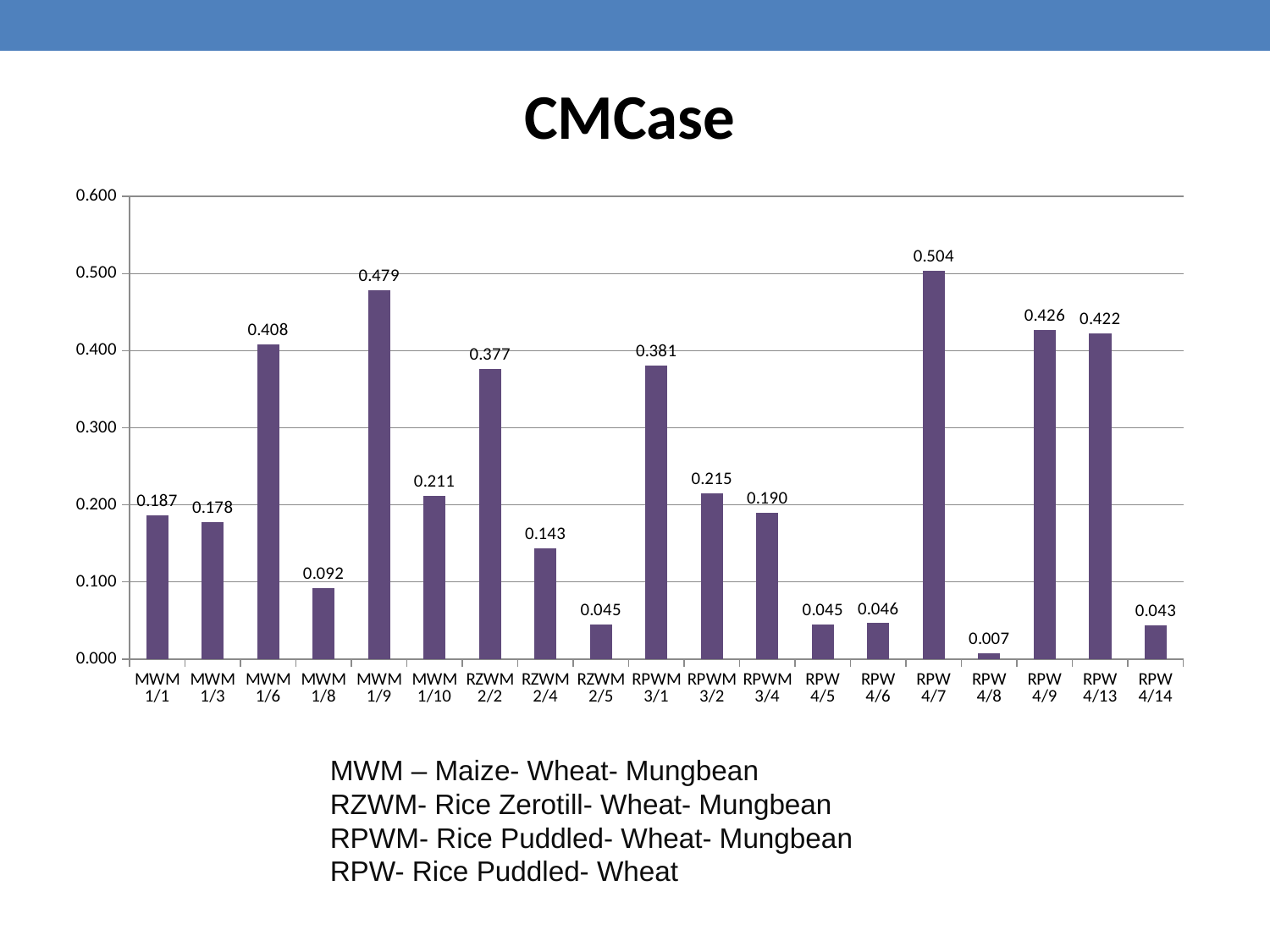
Which category has the lowest value? RPW 4/8 What is the title of the chart? CMCase What is the difference between the values for RPW 4/7 and MWM 1/9? 0.025 Which category has the highest value? RPW 4/7 What is the difference between the values for MWM 1/6 and MWM 1/8? 0.316 What is the value for RPW 4/13? 0.422 What is the value for RZWM 2/4? 0.143 What is the value for MWM 1/9? 0.479 What kind of chart is shown on the slide? bar chart Is the value for RPWM 3/1 greater or less than 0.300? greater Which is larger, the value for RPW 4/9 or the value for MWM 1/6? RPW 4/9 How many categories are shown on the x axis? 19